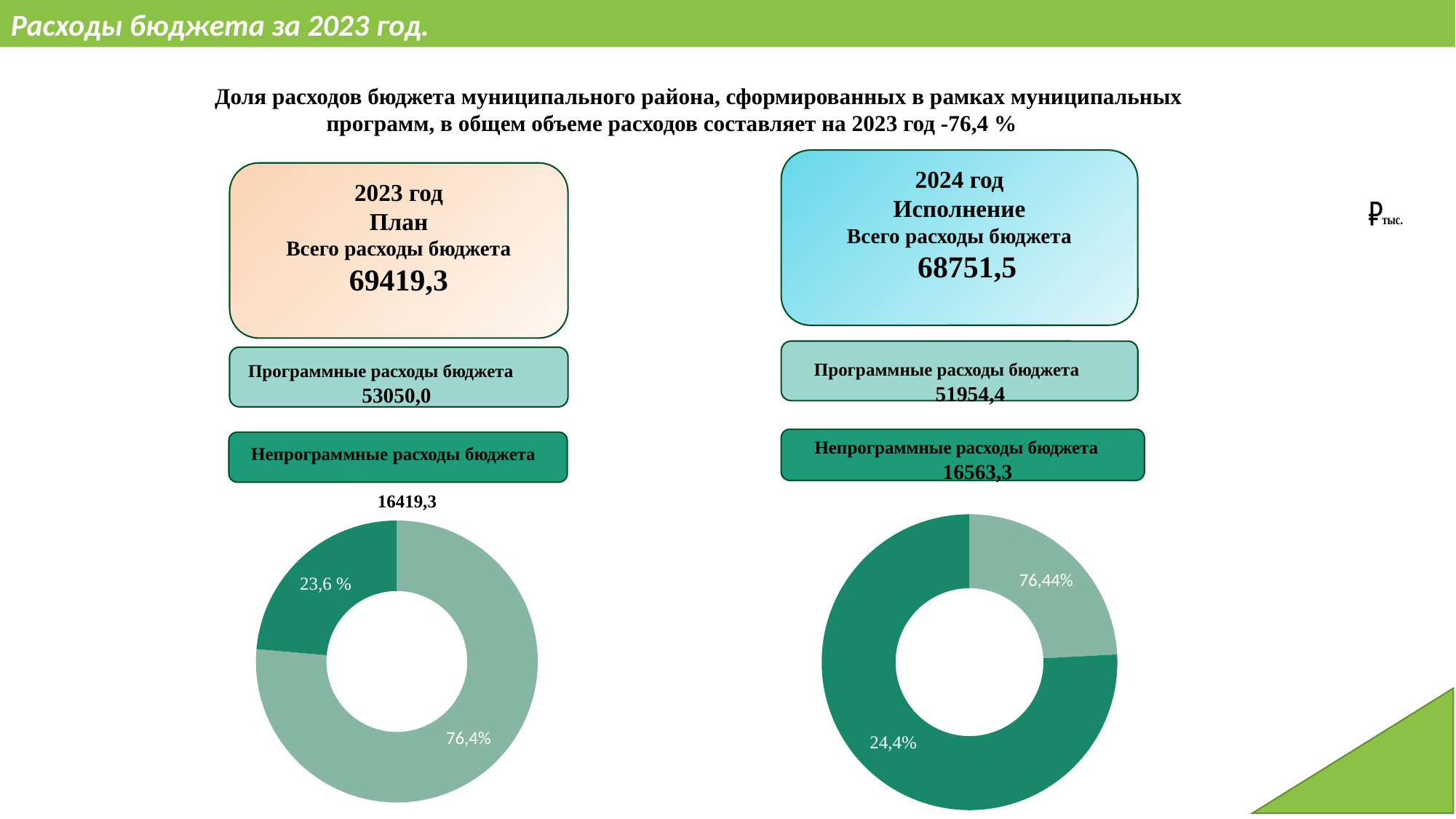
In the right doughnut chart (2024 год Исполнение), what percentage is shown on the light green slice? 76,44% In the left doughnut chart (2023 год План), what is the difference in percentage points between the 76,4% slice and the 23,6 % slice? 52,8 In the left doughnut chart (2023 год План), is the dark green slice's value greater or less than 50%? less How many slices does the left doughnut chart (2023 год План) have? 2 What kind of chart is shown on the left side of the slide under the 2023 год План block? doughnut chart In the left doughnut chart (2023 год План), what is the smallest slice's value? 23,6 % In the left doughnut chart (2023 год План), what percentage is shown on the light green slice? 76,4% In the left doughnut chart (2023 год План), what percentage is shown on the dark green slice? 23,6 % In the right doughnut chart (2024 год Исполнение), what percentage is shown on the dark green slice? 24,4% In the left doughnut chart (2023 год План), which slice is larger, the light green one or the dark green one? the light green one In the left doughnut chart (2023 год План), what is the largest slice's value? 76,4% How many slices does the right doughnut chart (2024 год Исполнение) have? 2